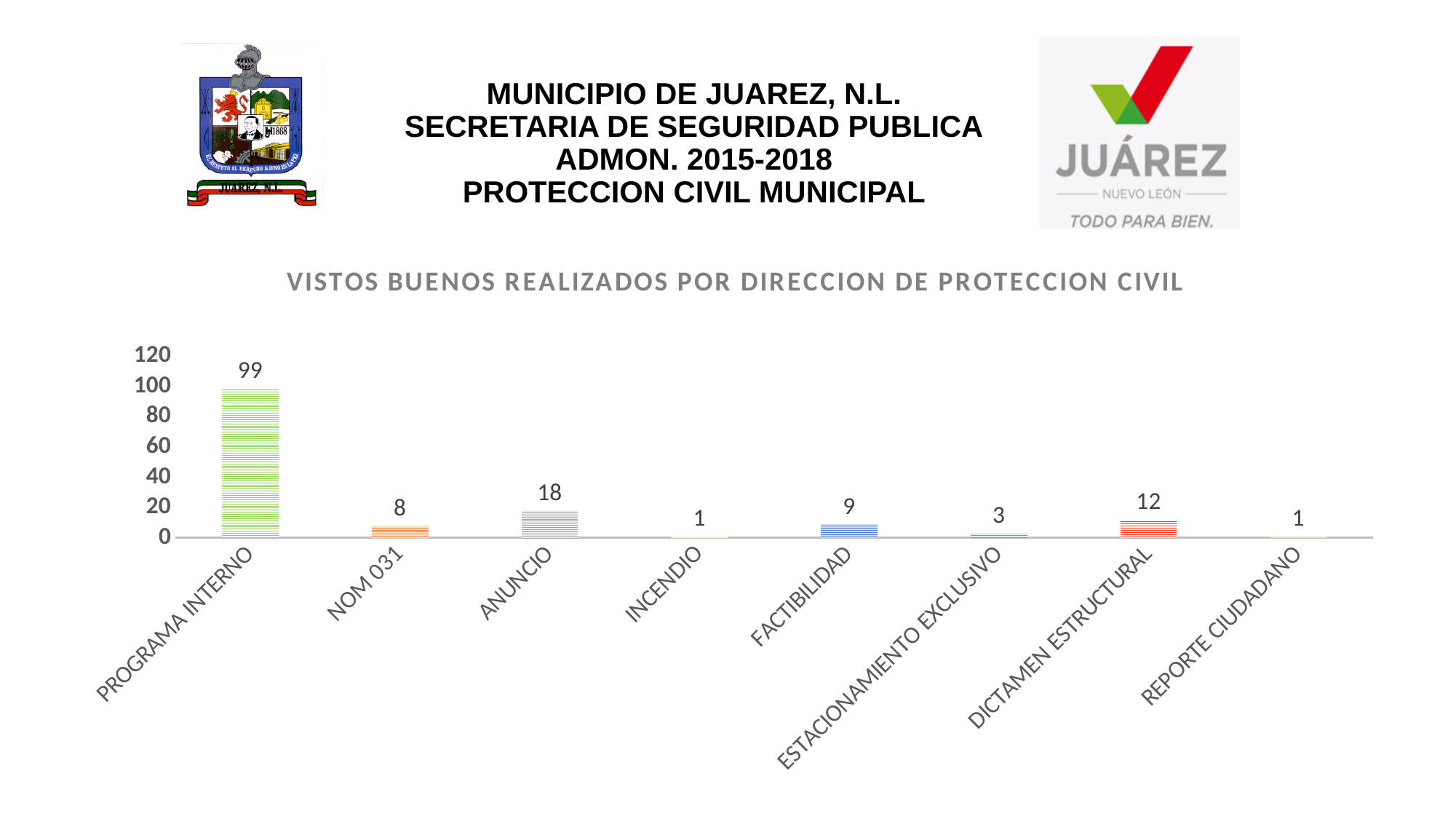
What is the difference between the values for PROGRAMA INTERNO and ANUNCIO? 81 What kind of chart is shown on the slide? bar chart What is the value for ESTACIONAMIENTO EXCLUSIVO? 3 How many categories are shown on the x axis? 8 What is the difference between the values for DICTAMEN ESTRUCTURAL and NOM 031? 4 What is the value for DICTAMEN ESTRUCTURAL? 12 What is the value for PROGRAMA INTERNO? 99 Is the value for PROGRAMA INTERNO greater or less than 80? greater Which is larger, the value for FACTIBILIDAD or the value for NOM 031? FACTIBILIDAD Which category has the highest value? PROGRAMA INTERNO What is the title of the chart? VISTOS BUENOS REALIZADOS POR DIRECCION DE PROTECCION CIVIL What is the value for ANUNCIO? 18